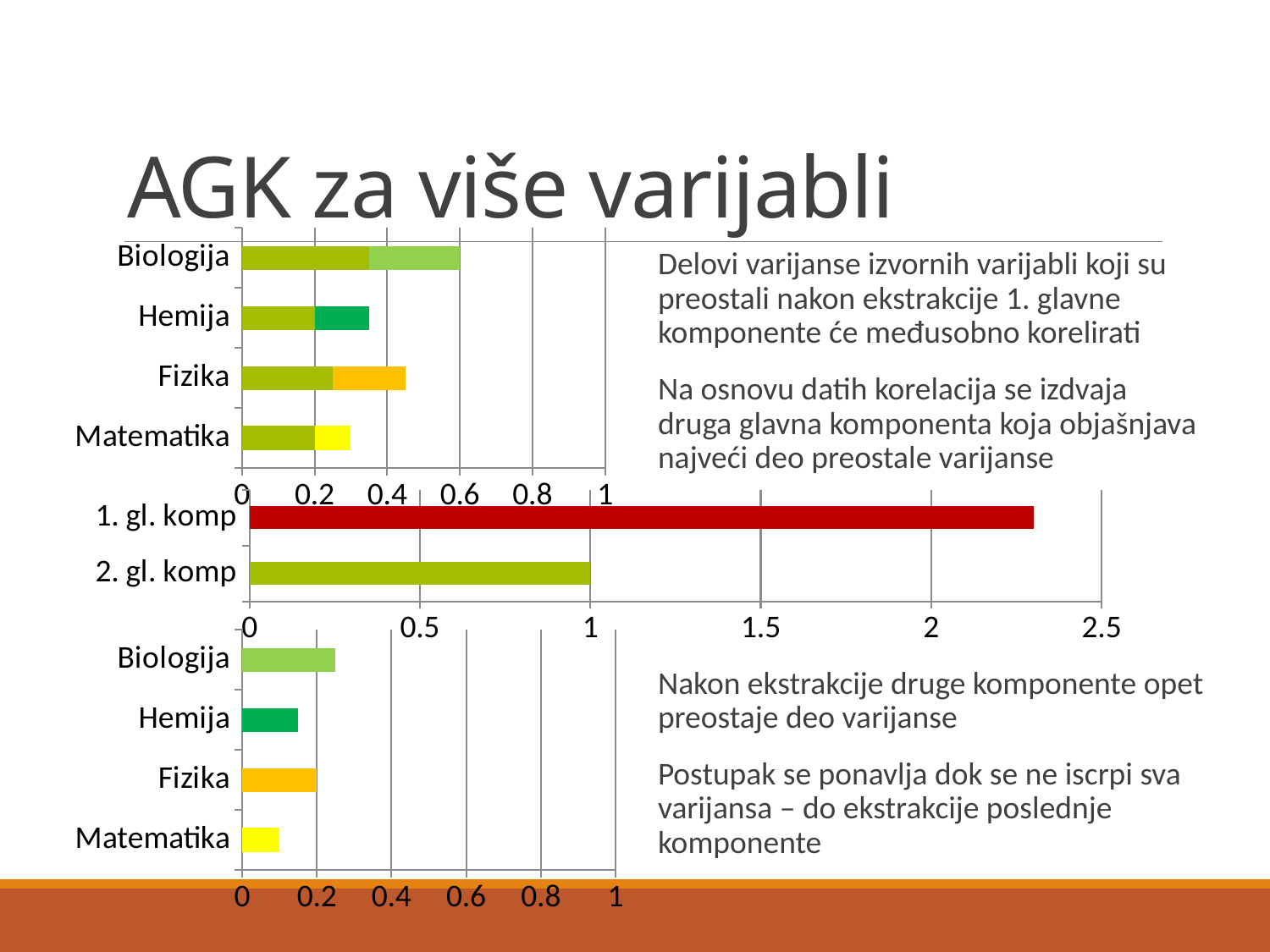
In the middle chart (1. gl. komp / 2. gl. komp), which category has the longest bar? 1. gl. komp What kind of chart is the bottom-left chart? bar chart In the top-left chart, which category has the shortest total bar? Matematika In the top-left chart, is the total value for Fizika greater or less than 0.4? greater In the top-left chart, which category has the longest total bar? Biologija In the bottom-left chart, which category has the shortest bar? Matematika In the bottom-left chart, is the value for Hemija greater or less than 0.2? less In the top-left chart, is the total value for Hemija greater or less than 0.4? less How many categories are shown in the middle chart? 2 In the bottom-left chart, which category has the longest bar? Biologija